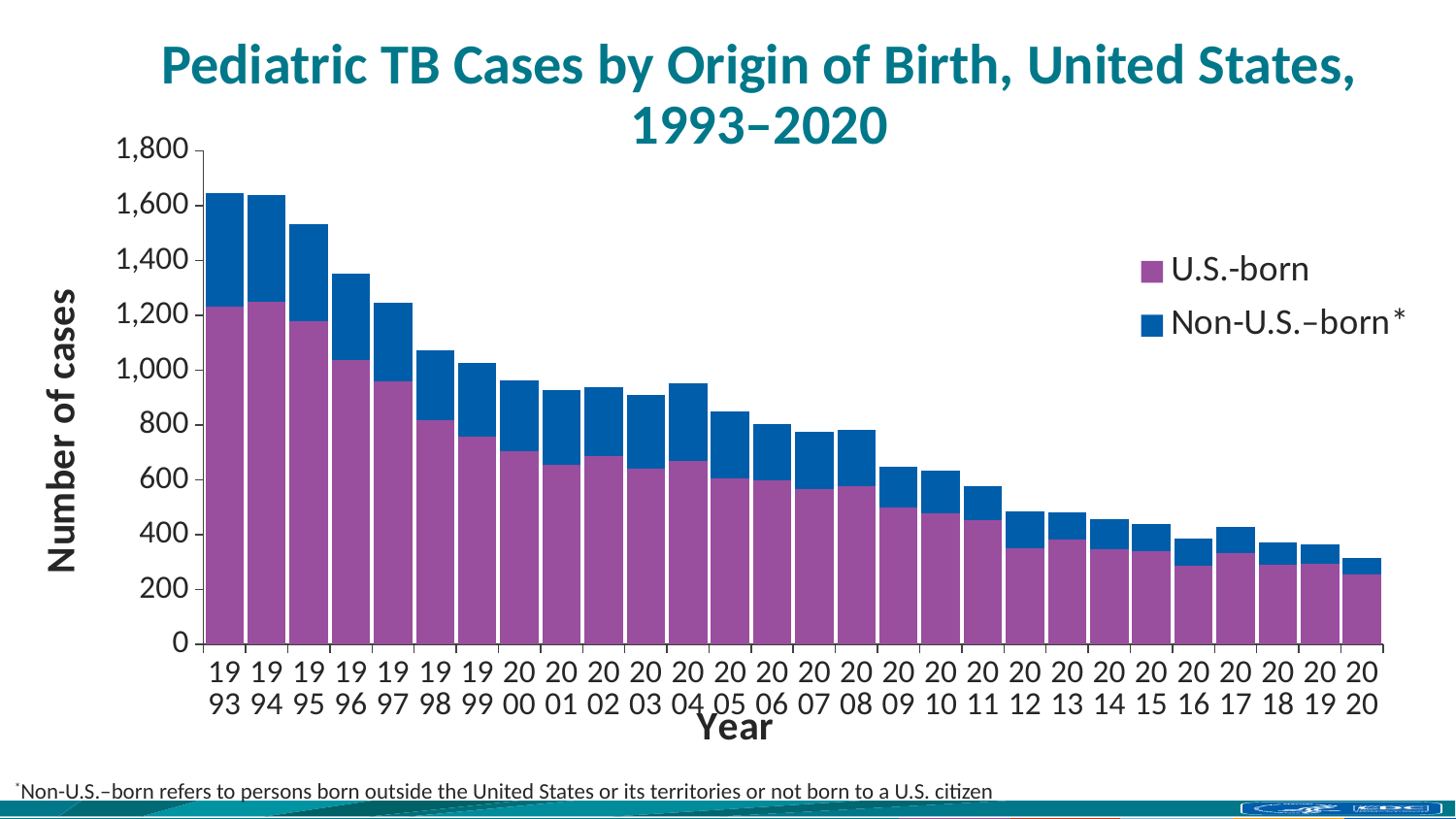
Is the total number of cases in 2012 greater or less than 600? less What is the title of the y axis? Number of cases How many series does the legend list? 2 Which series is shown in blue? Non-U.S.–born* Which year has the lowest total number of pediatric TB cases? 2020 How many years are shown along the x axis? 28 What kind of chart is shown on the slide? Stacked bar chart Is the total number of cases in 1993 greater or less than 1,400? greater Which year has the larger total number of cases, 1996 or 1998? 1996 Do the total number of cases generally rise or fall from 1993 to 2020? Fall Which year has the larger total number of cases, 2000 or 2010? 2000 Is the total number of cases in 2020 greater or less than 400? less